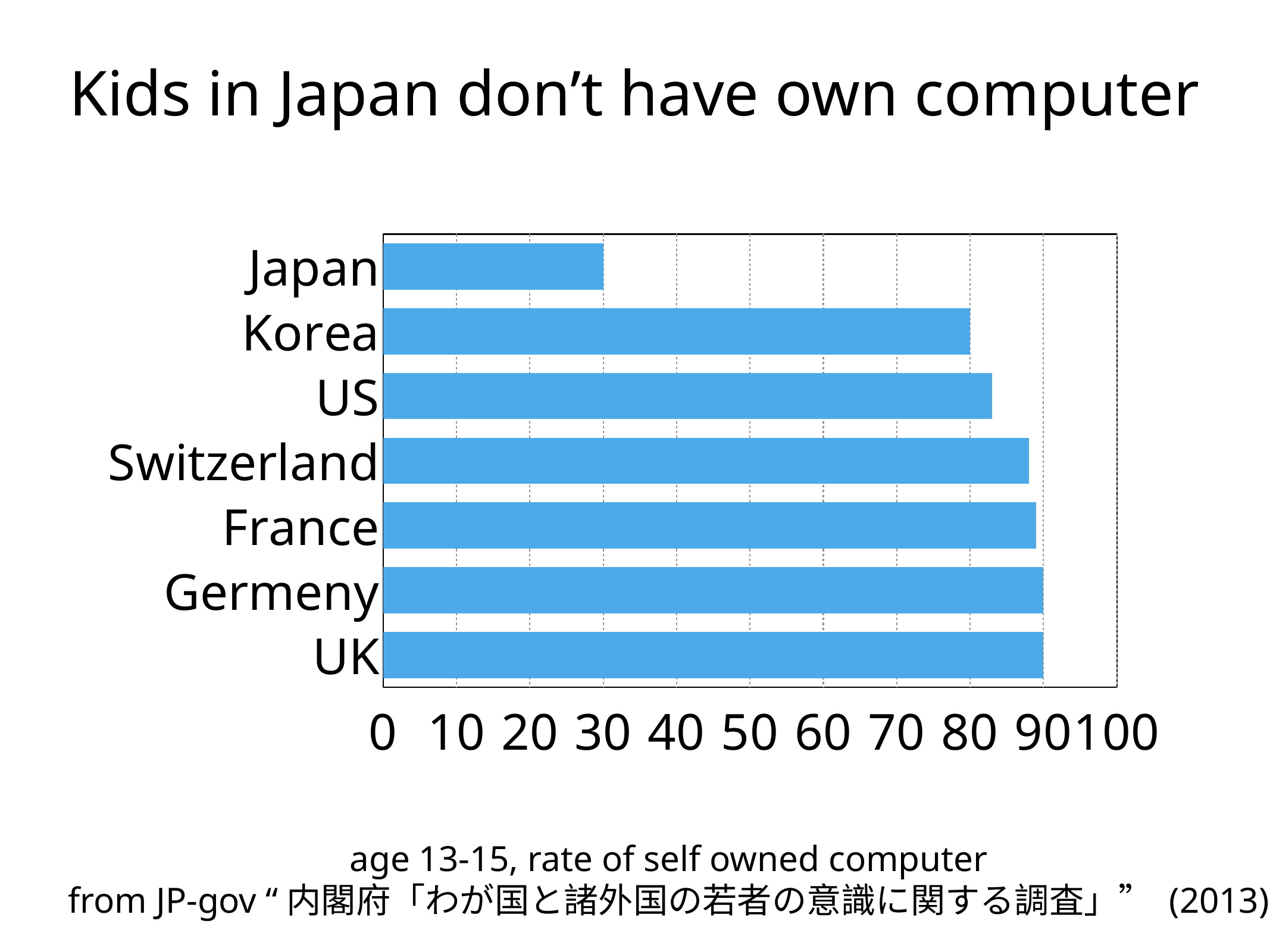
What is the value for Korea? 80 Which is larger, the value for Korea or the value for US? US Is the value for Switzerland greater or less than 80? greater Is the value for US greater or less than 80? greater What is the value for Japan? 30 Which country has the lowest rate of self owned computer? Japan Which is larger, the value for Japan or the value for Korea? Korea What is the difference between the values for Korea and Japan? 50 Is the value for France greater or less than 70? greater How many countries are shown in the chart? 7 What is the title of the slide? Kids in Japan don't have own computer What kind of chart is shown on the slide? bar chart